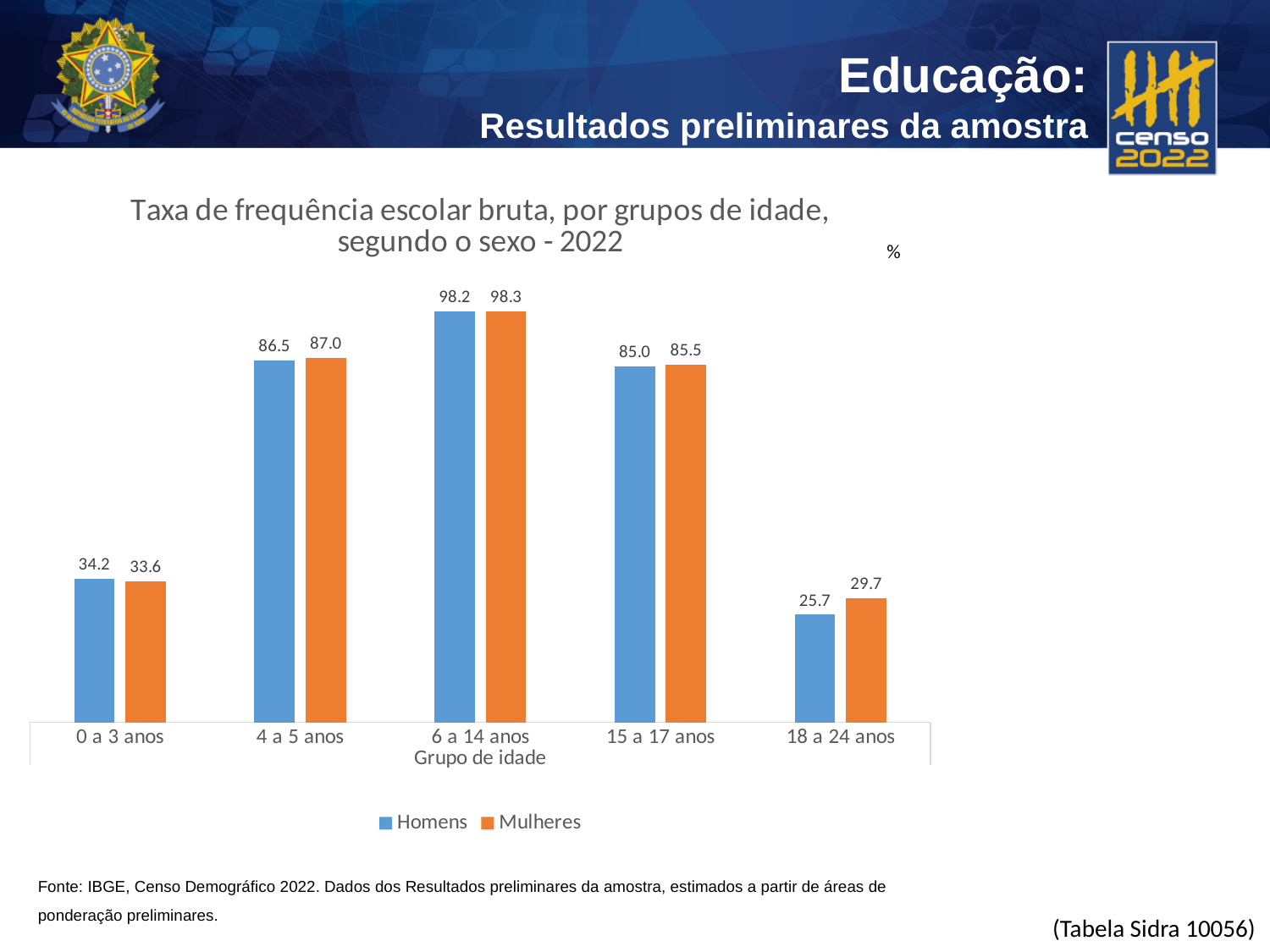
How many age groups are shown on the x axis? 5 How many series does the legend list? 2 What is the difference between the Homens values for 4 a 5 anos and 15 a 17 anos? 1.5 Which age group has the highest value for Homens? 6 a 14 anos Which age group has the lowest value for Mulheres? 18 a 24 anos What is the value for Mulheres in the 0 a 3 anos age group? 33.6 What is the difference between the Mulheres and Homens values in the 18 a 24 anos age group? 4.0 What is the value for Homens in the 6 a 14 anos age group? 98.2 What is the value for Mulheres in the 18 a 24 anos age group? 29.7 Which colour represents Mulheres in the chart? Orange In the 0 a 3 anos age group, which is larger, the value for Homens or for Mulheres? Homens What kind of chart is shown on the slide? Bar chart